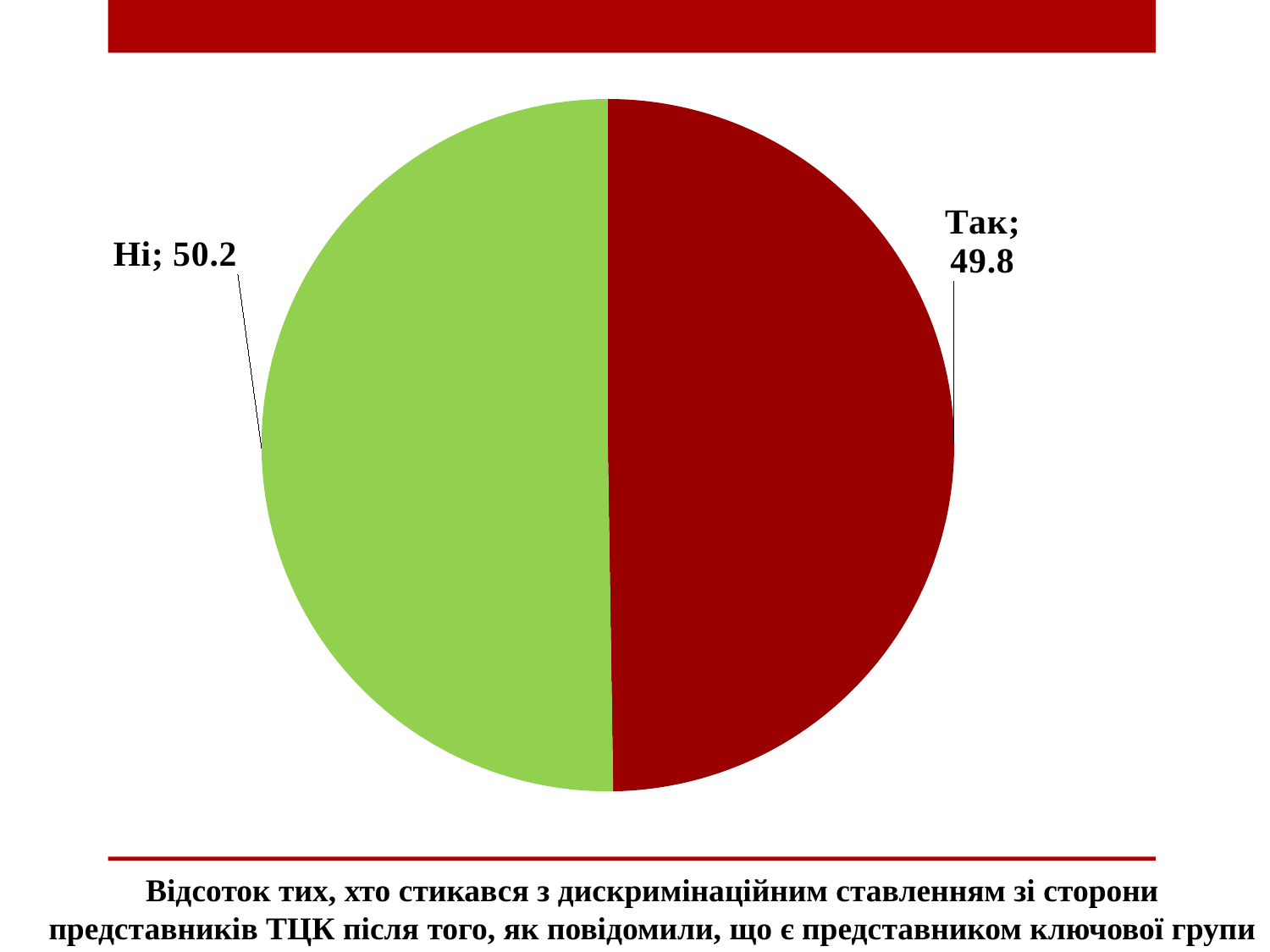
What is the value shown for the "Ні" slice of the pie chart? 50.2 What kind of chart is shown on the slide? pie chart Is the value for "Ні" larger or smaller than the value for "Так"? larger What is the difference between the values for "Ні" and "Так" in the pie chart? 0.4 Which slice of the pie chart has the smaller value? Так Which slice of the pie chart has the larger value? Ні How many slices does the pie chart have? 2 What is the value shown for the "Так" slice of the pie chart? 49.8 What share of the pie does the "Так" slice represent? 49.8 What colour is the "Так" slice of the pie chart? red What colour is the "Ні" slice of the pie chart? green